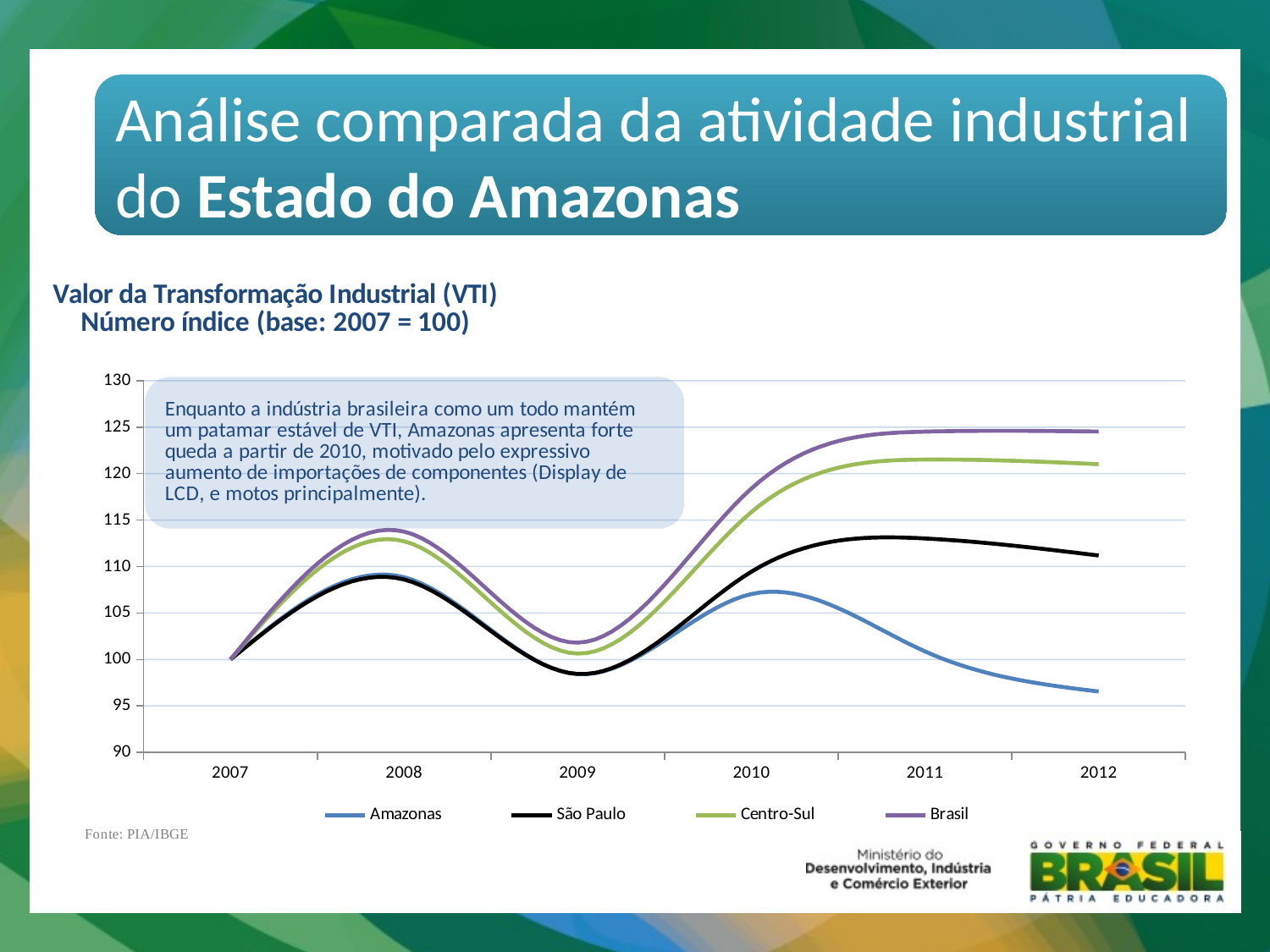
How many years are shown on the x axis of the chart? 6 Which is larger in 2012, the value for Brasil or the value for Amazonas? Brasil Which series has the highest value in 2012? Brasil Is the value for Brasil in 2012 greater or less than 120? greater Does the Amazonas line rise or fall from 2010 to 2012? fall Is the value for São Paulo in 2009 greater or less than 100? less Which series has the lowest value in 2012? Amazonas What kind of chart is shown on the slide? line chart What is the base year of the index shown in the chart? 2007 How many series does the chart legend list? 4 Is the value for Amazonas in 2012 greater or less than 100? less What is the value for Amazonas in 2007? 100